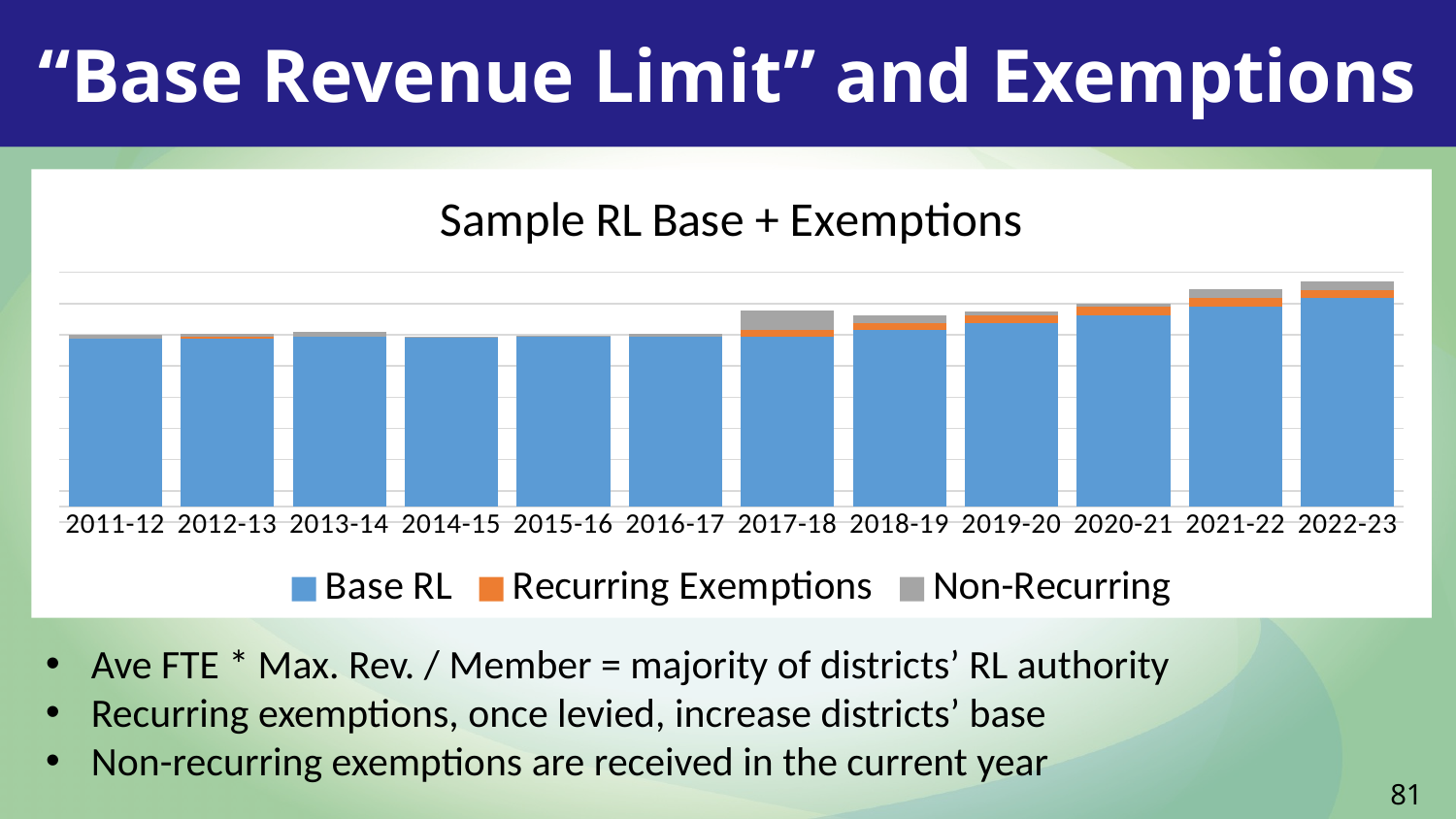
Which year shows the largest Non-Recurring segment in the chart? 2017-18 What is the title of the chart? Sample RL Base + Exemptions Do the total bar heights generally rise or fall from 2011-12 to 2022-23? Rise Which series makes up the largest portion of every bar in the chart? Base RL Is the Base RL segment for 2021-22 larger or smaller than the Base RL segment for 2016-17? Larger What type of chart is shown on the slide? Stacked bar chart Is the total bar for 2022-23 larger or smaller than the total bar for 2011-12? Larger What is the first year on the x axis of the chart? 2011-12 Which year has the tallest total bar in the chart? 2022-23 Which series are listed in the chart legend? Base RL, Recurring Exemptions, Non-Recurring How many series does the chart legend list? 3 How many school years are shown on the x axis of the chart? 12